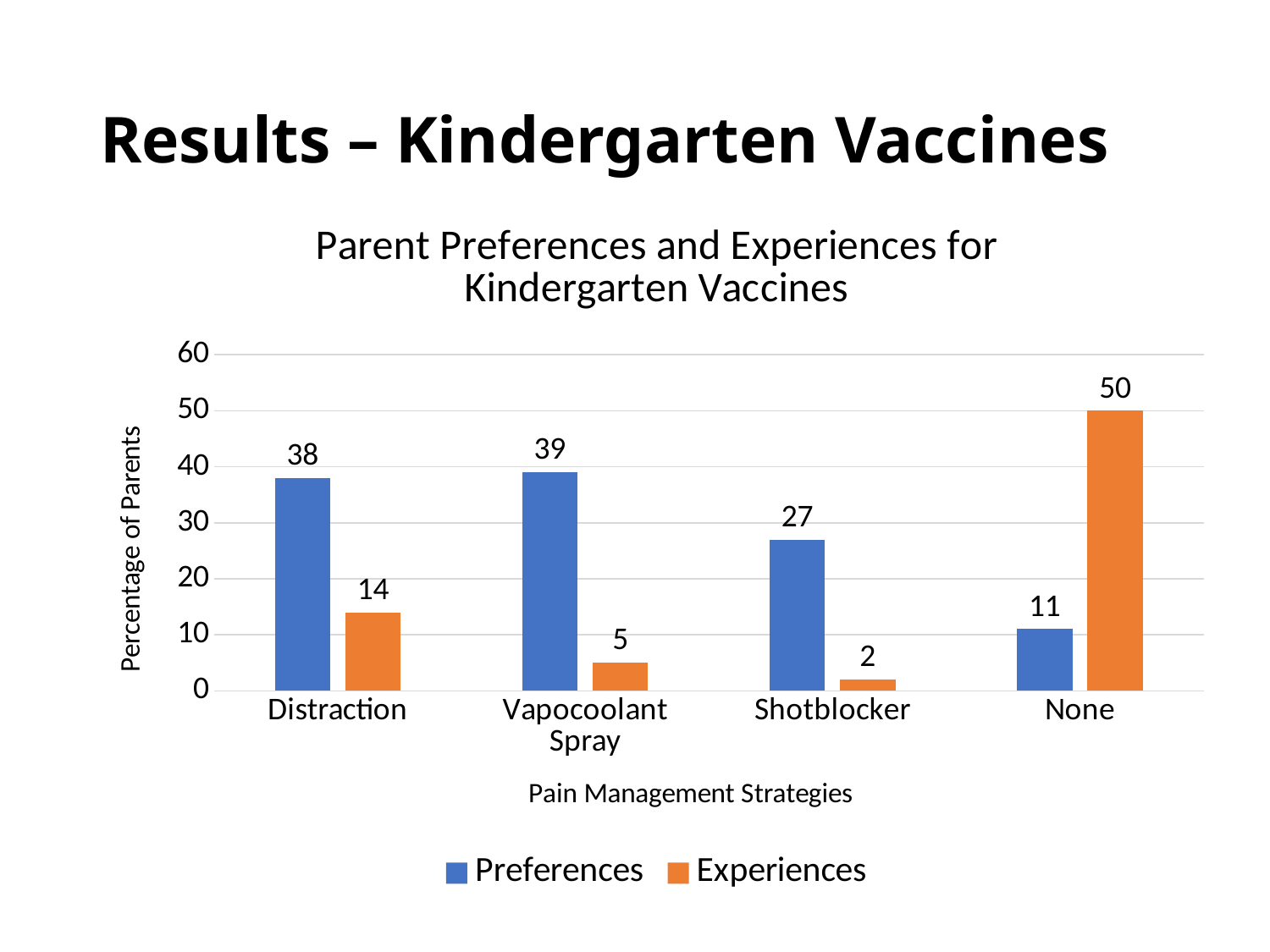
How many pain management strategies are shown on the x axis? 4 Is the Preferences value for Shotblocker greater or less than 20? greater Which pain management strategy has the highest Preferences value? Vapocoolant Spray What kind of chart is shown on the slide? Bar chart How many series does the legend list? 2 Which is larger for None: the Preferences value or the Experiences value? Experiences What is the title of the chart? Parent Preferences and Experiences for Kindergarten Vaccines What is the Experiences value for None? 50 What is the Preferences value for Distraction? 38 What is the difference between the Preferences and Experiences values for Distraction? 24 Which pain management strategy has the lowest Experiences value? Shotblocker What is the Experiences value for Shotblocker? 2